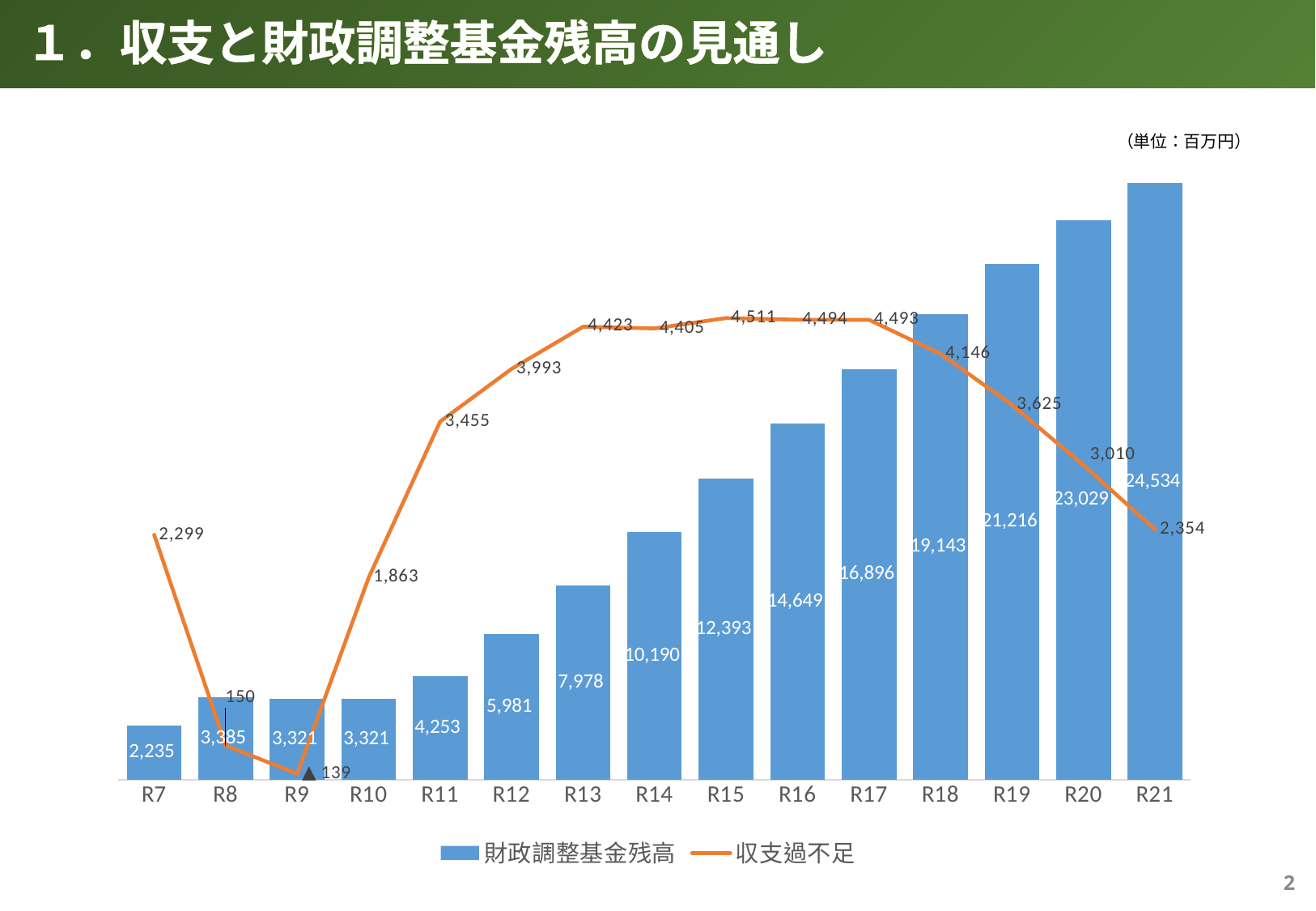
Does the 財政調整基金残高 rise or fall from R10 to R21? Rise What is the 収支過不足 value for R13? 4,423 What kind of chart is this? Combined bar and line chart Which year has the lowest 財政調整基金残高? R7 How many series does the legend list? 2 What is the 収支過不足 value for R9? ▲139 Which year has the highest 財政調整基金残高? R21 Which year has the highest 収支過不足 value? R15 What is the difference between the 財政調整基金残高 for R21 and R20? 1,505 What is the 財政調整基金残高 value for R15? 12,393 How many years are shown on the x axis? 15 Which is larger, the 収支過不足 for R7 or for R21? R21